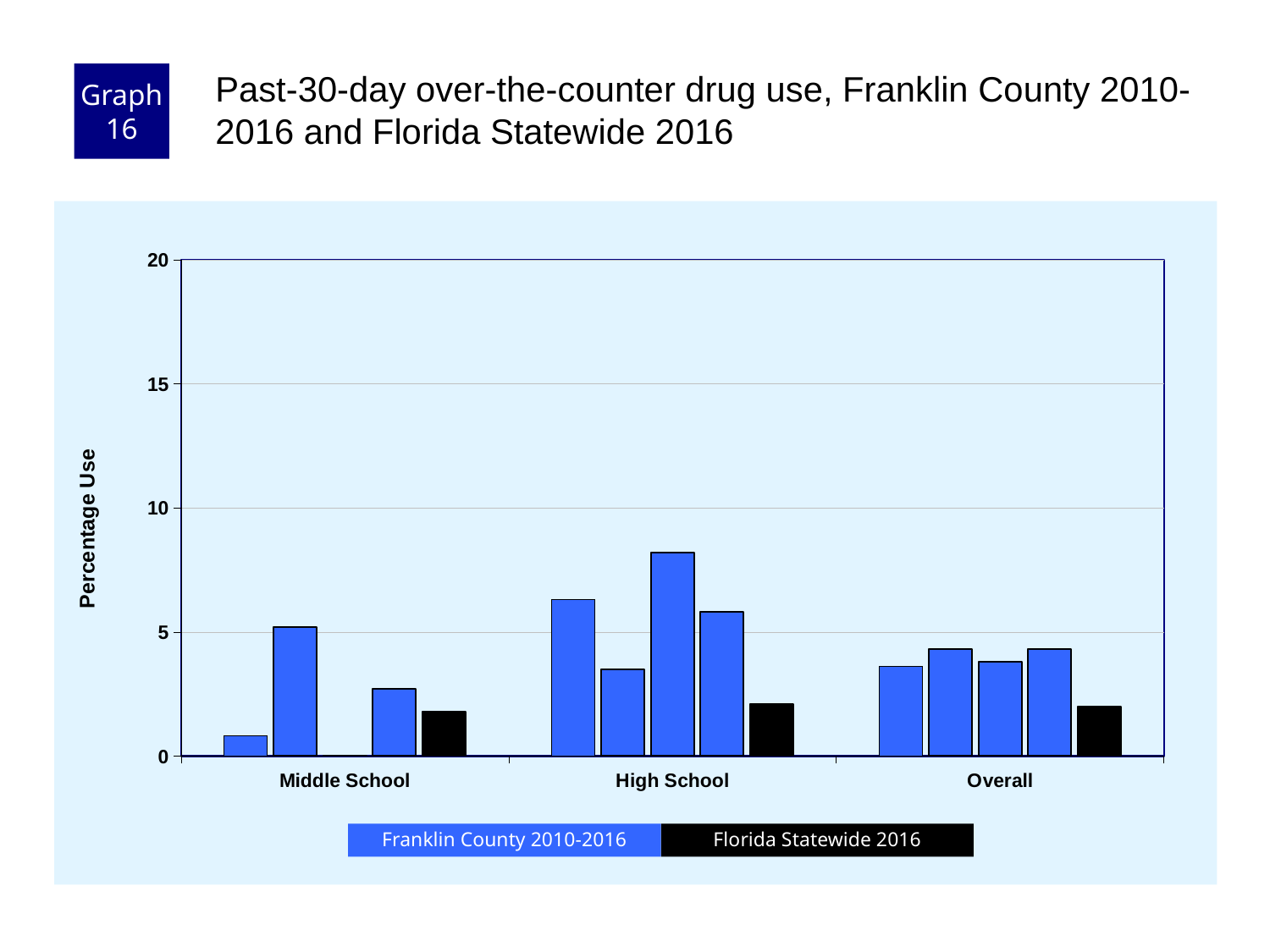
Is the Florida Statewide 2016 value for High School greater or less than 5? less Is the tallest Franklin County 2010-2016 bar for High School greater or less than 5? greater What kind of chart is shown on the slide? bar chart Is the Florida Statewide 2016 value for Middle School greater or less than 5? less Which is larger: the tallest bar in the High School group or the tallest bar in the Middle School group? High School What is the label on the y axis? Percentage Use Which category contains the tallest bar in the chart? High School Which series is shown in black in the legend? Florida Statewide 2016 How many categories are shown on the x axis? 3 How many series does the legend list? 2